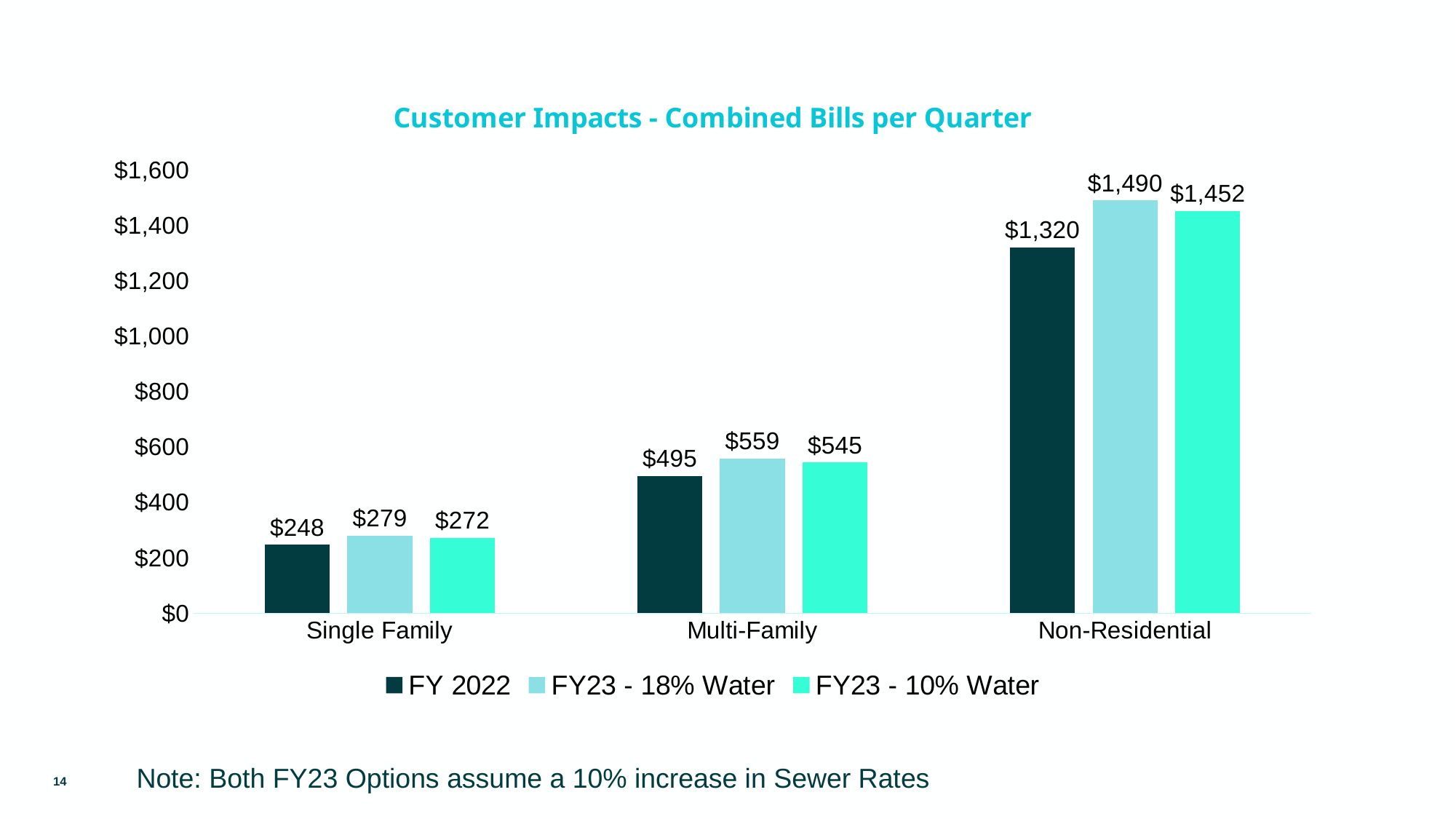
What is the difference between the FY23 - 18% Water and FY23 - 10% Water values for Non-Residential? $38 What is the FY 2022 combined bill per quarter for Single Family customers? $248 What is the title of the chart? Customer Impacts - Combined Bills per Quarter Which customer category has the lowest FY23 - 18% Water combined bill? Single Family Which is larger for Single Family: the FY23 - 18% Water value or the FY23 - 10% Water value? FY23 - 18% Water What is the difference between the FY23 - 18% Water and FY 2022 values for Multi-Family? $64 How many customer categories are shown on the x axis? 3 What is the FY23 - 10% Water value for Multi-Family customers? $545 Which customer category has the highest FY 2022 combined bill? Non-Residential What is the FY23 - 18% Water value for Non-Residential customers? $1,490 How many series does the legend list? 3 What kind of chart is shown on the slide? Bar chart